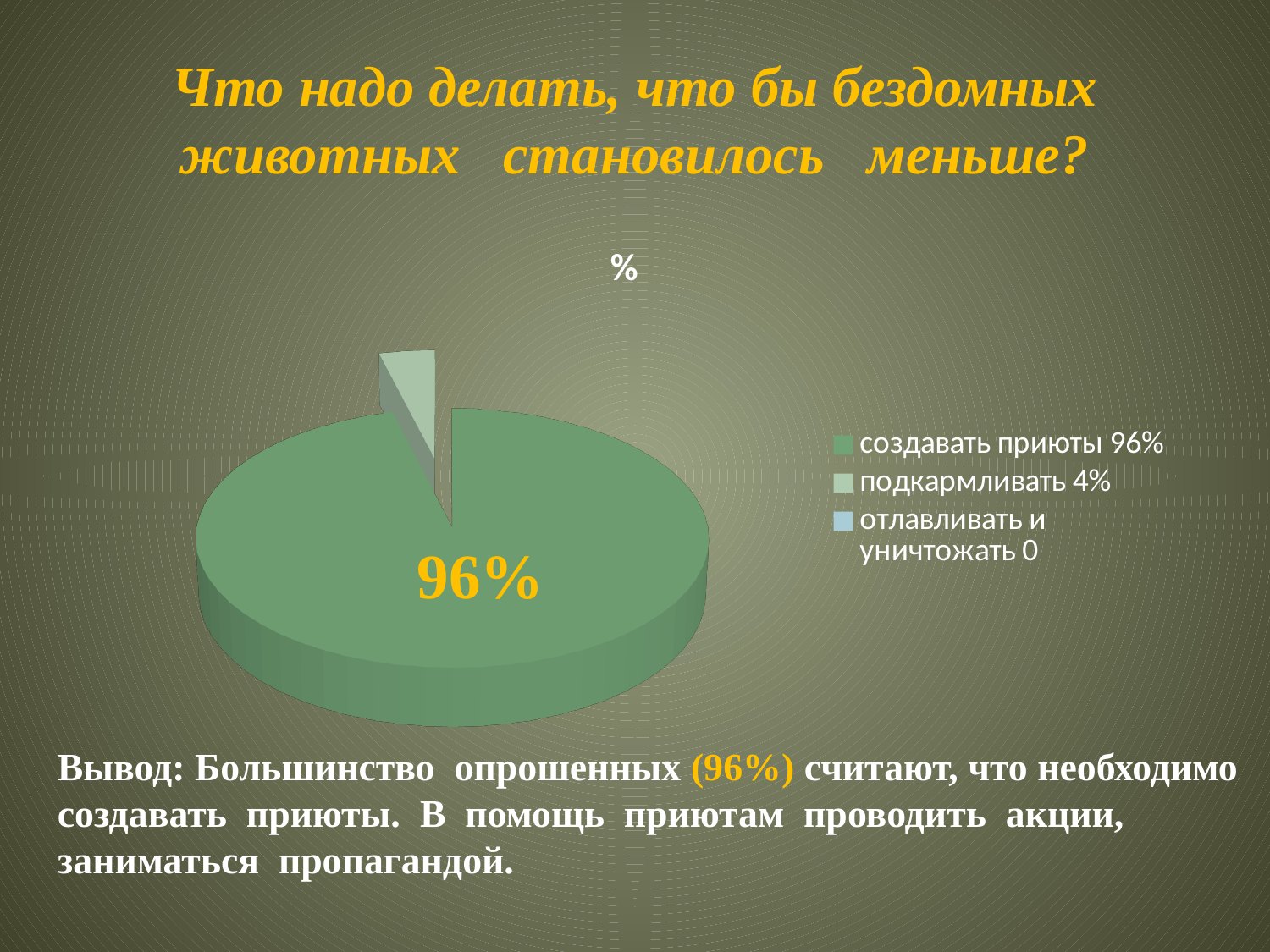
Which is larger: the share for "создавать приюты" or for "подкармливать"? создавать приюты Which category has the smallest value in the legend? отлавливать и уничтожать What is the difference between the shares for "создавать приюты" and "подкармливать"? 92% What share of the pie does "подкармливать" take? 4% What value is shown for "отлавливать и уничтожать" in the legend? 0 What share of the pie does "создавать приюты" take? 96% What is the title of the chart? % What kind of chart is shown on the slide? pie chart Which category has the largest slice of the pie? создавать приюты What is the combined share of "создавать приюты" and "подкармливать"? 100% How many categories does the legend list? 3 What data label is printed on the large slice of the pie? 96%